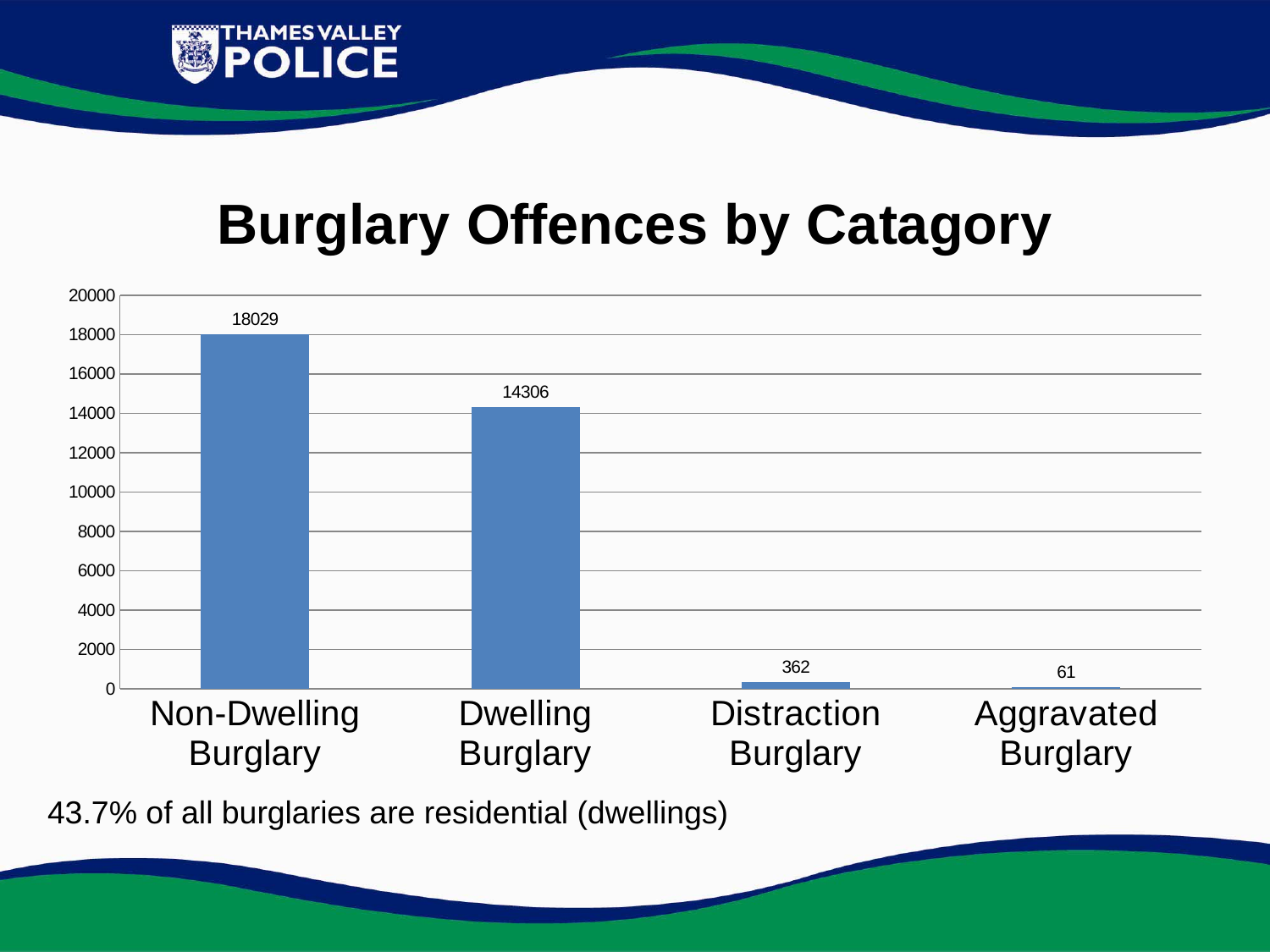
Which category has the lowest number of offences? Aggravated Burglary What is the title of the chart? Burglary Offences by Catagory What is the value for Distraction Burglary? 362 Which is larger, Dwelling Burglary or Distraction Burglary? Dwelling Burglary How many categories are shown on the chart? 4 Which category has the highest number of offences? Non-Dwelling Burglary What kind of chart is shown on the slide? Bar chart What is the value for Non-Dwelling Burglary? 18029 What is the difference between Non-Dwelling Burglary and Dwelling Burglary? 3723 What is the value for Aggravated Burglary? 61 What is the difference between Distraction Burglary and Aggravated Burglary? 301 What is the value for Dwelling Burglary? 14306